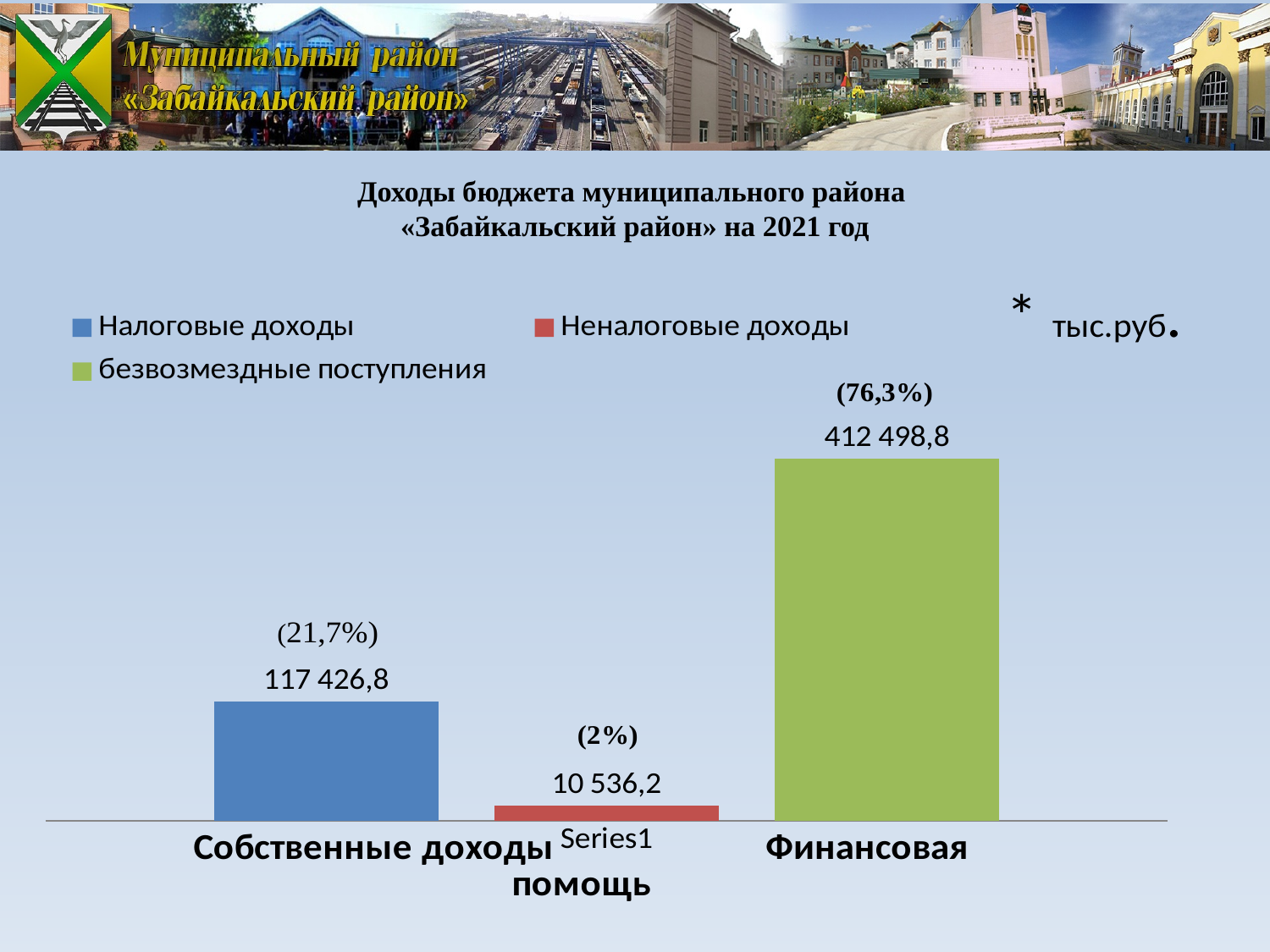
What percentage share is shown for Налоговые доходы? 21,7% What percentage share is shown for безвозмездные поступления? 76,3% What is the value for Налоговые доходы? 117 426,8 What is the value for Неналоговые доходы? 10 536,2 What is the value for безвозмездные поступления? 412 498,8 What kind of chart is shown on the slide? bar chart What unit of measurement is indicated for the chart values? тыс.руб. Which is larger, Налоговые доходы or Неналоговые доходы? Налоговые доходы Which series has the lowest value? Неналоговые доходы How many series does the legend list? 3 What is the difference between безвозмездные поступления and Налоговые доходы? 295 072,0 Which series has the highest value? безвозмездные поступления